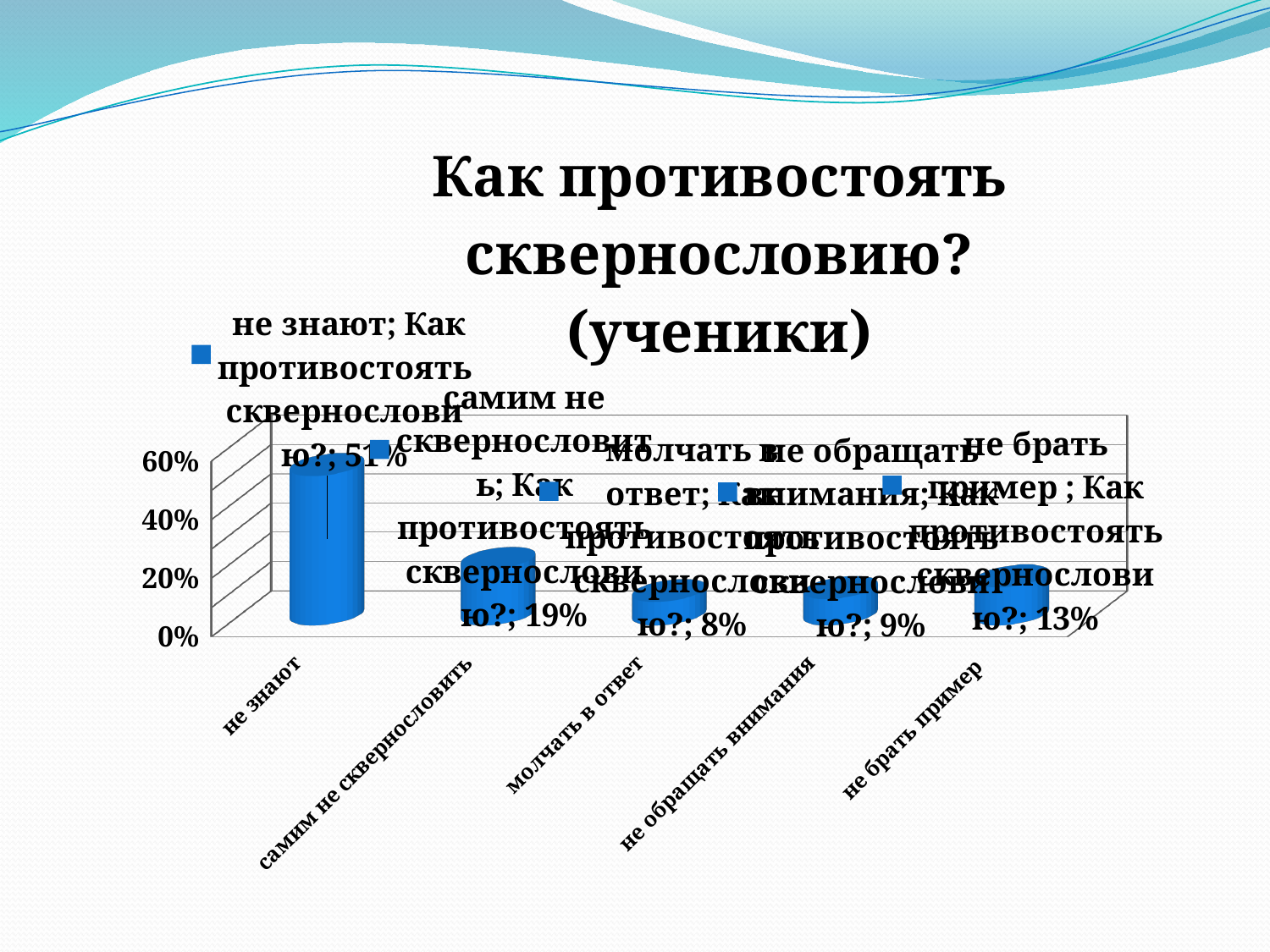
How many categories are shown on the chart? 5 Which category has the lowest value? молчать в ответ What is the value for "не обращать внимания"? 9% Is the value for "не знают" greater or less than 40%? greater Which is larger, the value for "не брать пример" or the value for "не обращать внимания"? не брать пример What is the value for "не знают"? 51% What kind of chart is shown on the slide? bar chart What is the value for "самим не сквернословить"? 19% What is the value for "молчать в ответ"? 8% What is the value for "не брать пример"? 13% Which category has the highest value? не знают What is the difference between the values for "не знают" and "самим не сквернословить"? 32%